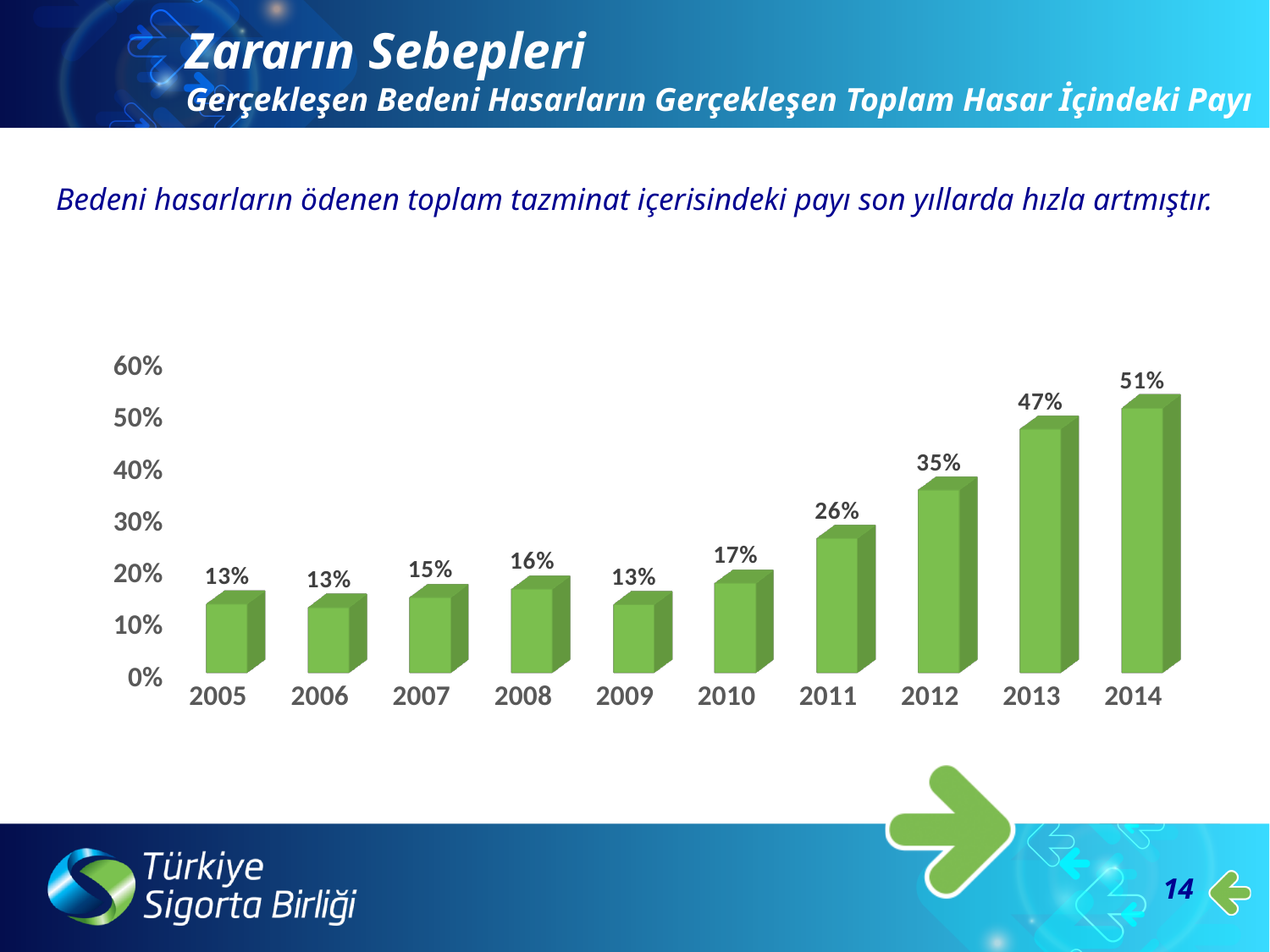
How many years are shown on the x axis? 10 Which year has the highest value? 2014 Is the value for 2007 greater or less than 20%? less What is the difference between the values for 2013 and 2012? 12% Is the value for 2012 greater or less than 30%? greater What kind of chart is shown on the slide? bar chart Which is larger, the value for 2010 or the value for 2009? 2010 Do the values generally rise or fall from 2009 to 2014? rise What is the value for 2008? 16% What is the difference between the values for 2014 and 2005? 38% What is the value for 2011? 26% What is the value for 2014? 51%